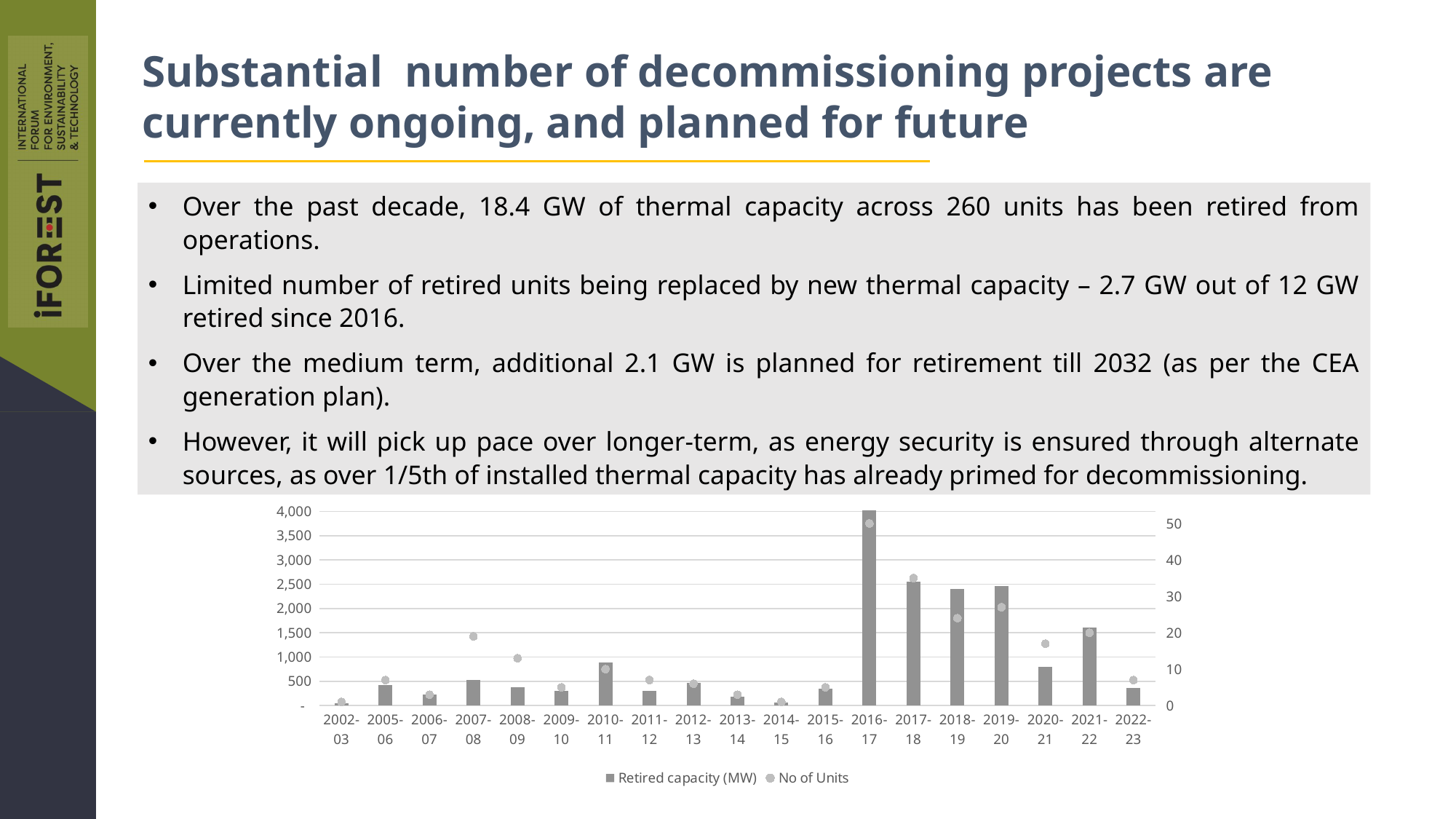
What are the two series named in the chart legend? Retired capacity (MW) and No of Units Which year has the highest retired capacity (MW) bar? 2016-17 Is the retired capacity (MW) for 2021-22 greater or less than 1,000? greater How many year categories are shown on the x axis of the chart? 19 Is the retired capacity (MW) for 2020-21 greater or less than 1,000? less Is the number of units for 2016-17 greater or less than 40? greater What kind of chart is shown on the slide? bar chart Which year has the larger retired capacity (MW) bar, 2016-17 or 2017-18? 2016-17 Which year has the highest number of units (dot marker)? 2016-17 How many series does the chart legend list? 2